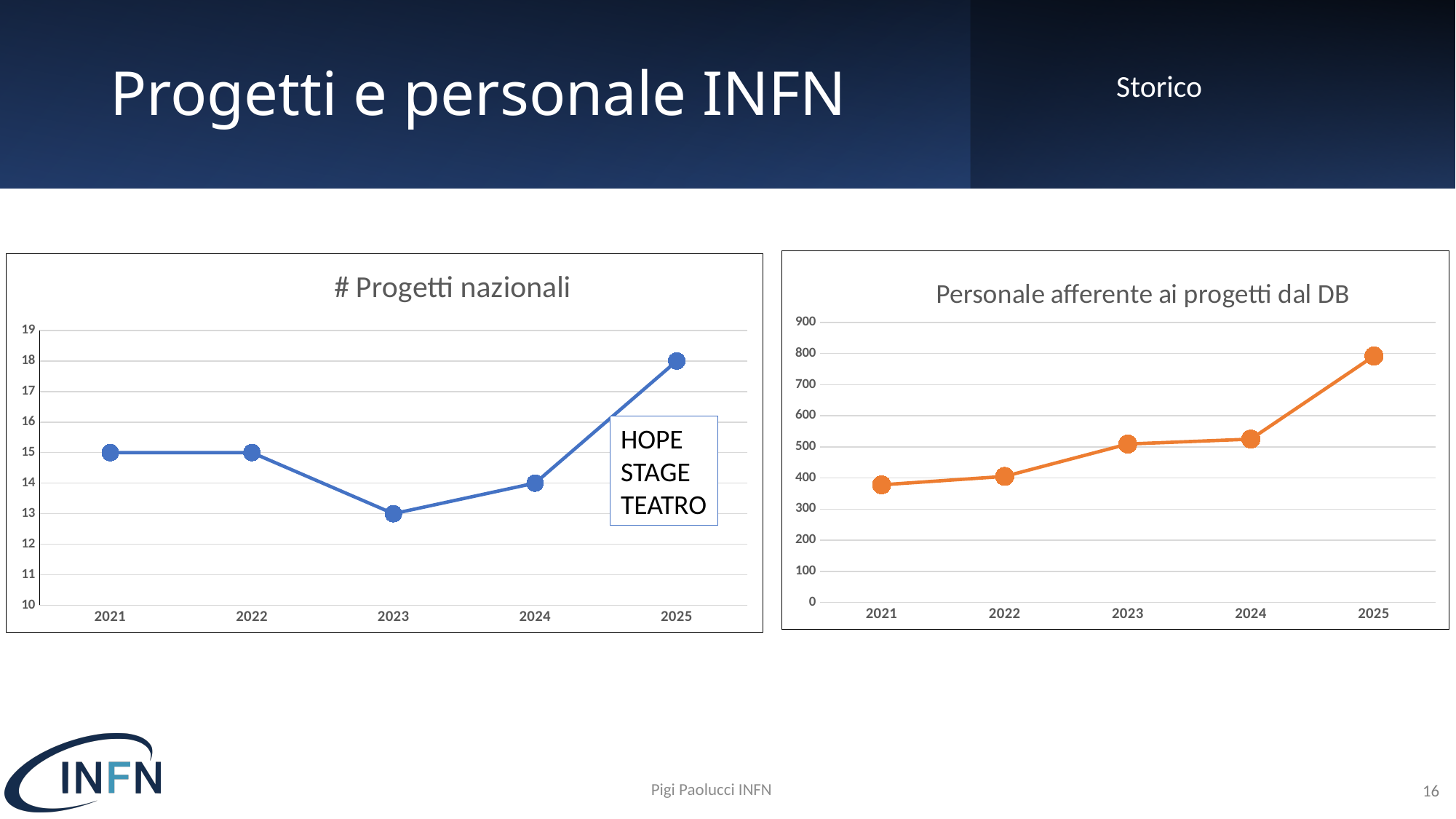
In the '# Progetti nazionali' chart, what is the value for 2023? 13 How many years are plotted in the '# Progetti nazionali' chart? 5 What is the title of the chart on the right of the slide? Personale afferente ai progetti dal DB In the '# Progetti nazionali' chart, which year has the lowest value? 2023 In the 'Personale afferente ai progetti dal DB' chart, do the values rise or fall from 2021 to 2025? rise In the '# Progetti nazionali' chart, what is the difference between the values for 2025 and 2024? 4 What kind of chart is the '# Progetti nazionali' chart? line chart In the '# Progetti nazionali' chart, what is the value for 2025? 18 In the 'Personale afferente ai progetti dal DB' chart, is the value for 2025 greater or less than 700? greater In the 'Personale afferente ai progetti dal DB' chart, which year has the highest value? 2025 In the '# Progetti nazionali' chart, which year has the highest value? 2025